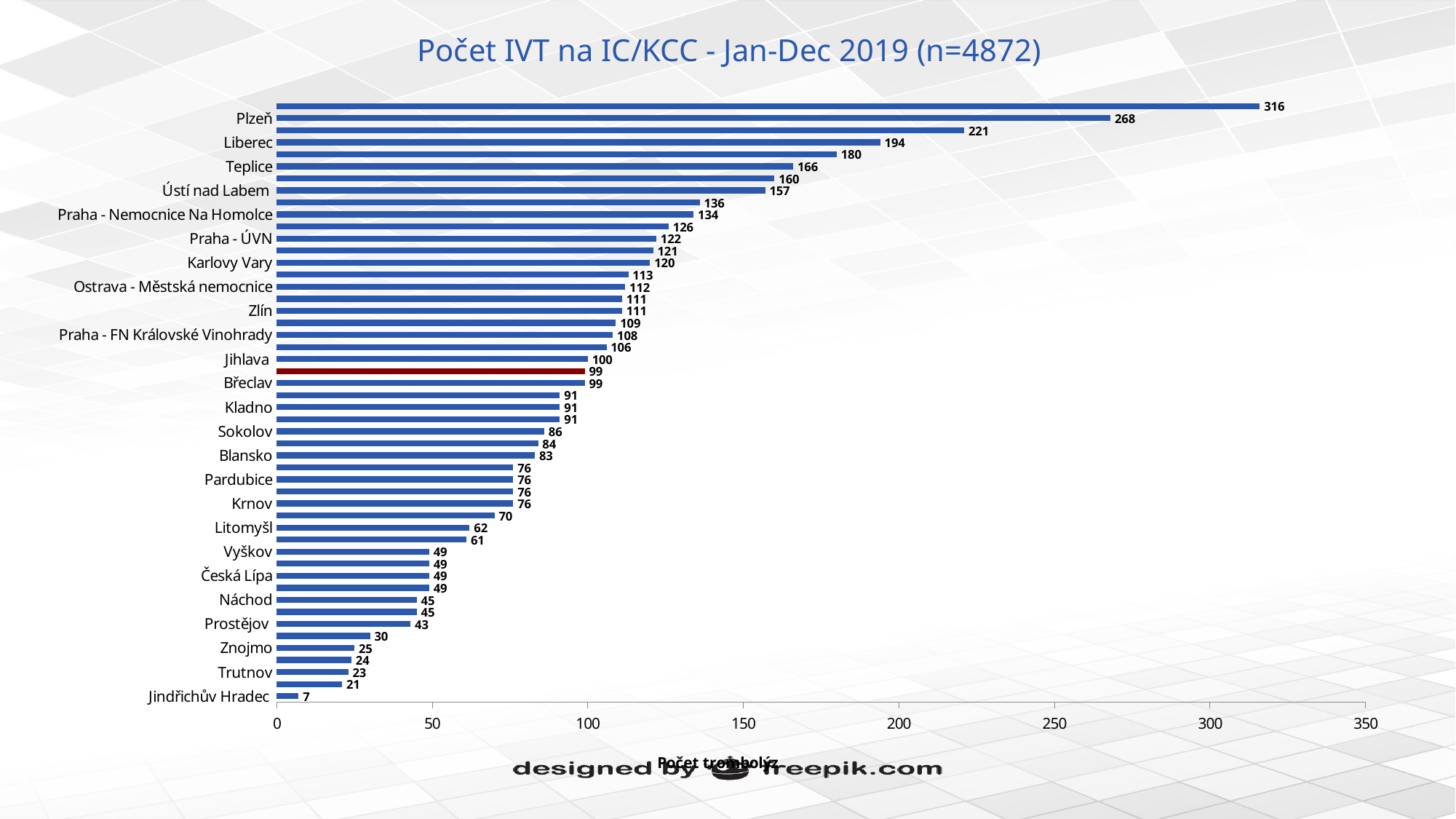
Do the bar values increase or decrease from the top of the chart to the bottom? Decrease Which labelled category has the lowest value? Jindřichův Hradec Which is larger, the value for Teplice or the value for Ústí nad Labem? Teplice What is the title of the chart? Počet IVT na IC/KCC - Jan-Dec 2019 (n=4872) What is the difference between the values for Plzeň and Liberec? 74 Is the value for Karlovy Vary greater or less than 100? greater What is the value for Jihlava? 100 What is the value for Liberec? 194 What colour is the single highlighted bar that differs from the others? Red What kind of chart is shown on the slide? Bar chart What is the value for Plzeň? 268 What is the value for Jindřichův Hradec? 7